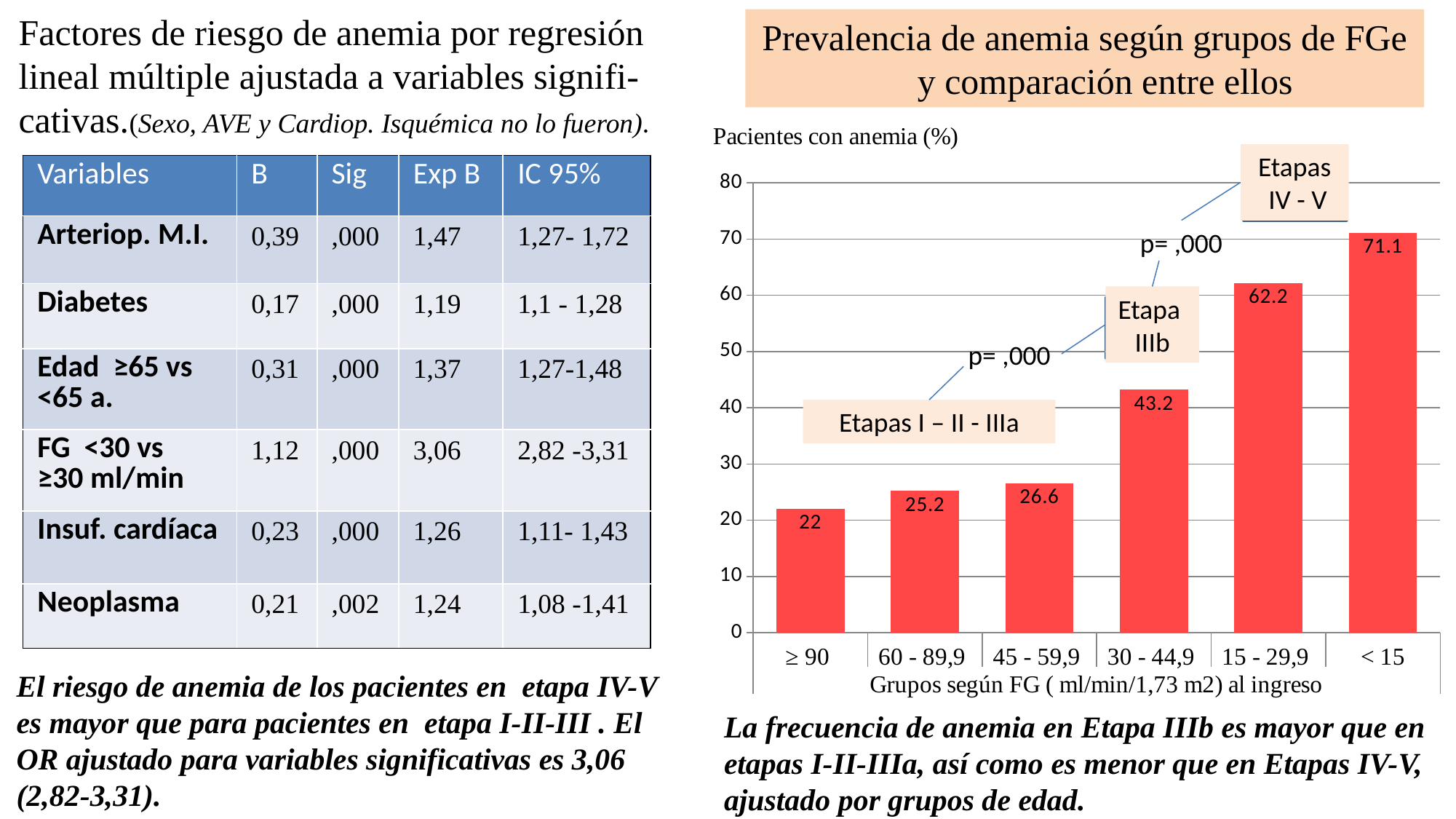
What percentage of patients with anemia is shown for the FG group '< 15'? 71.1 How many FG groups are shown on the x axis of the chart? 6 Which FG group has the highest prevalence of anemia? < 15 Which is larger, the value for '60 - 89,9' or the value for '45 - 59,9'? 45 - 59,9 What is the difference between the values for '15 - 29,9' and '30 - 44,9'? 19 What is the value for the FG group '≥ 90'? 22 Do the values rise or fall from left to right along the x axis? rise Which FG group has the lowest prevalence of anemia? ≥ 90 What is the title of the chart? Pacientes con anemia (%) What is the value for the FG group '30 - 44,9' in the chart? 43.2 Is the value for '15 - 29,9' greater or less than 60? greater What kind of chart is shown on the slide? bar chart